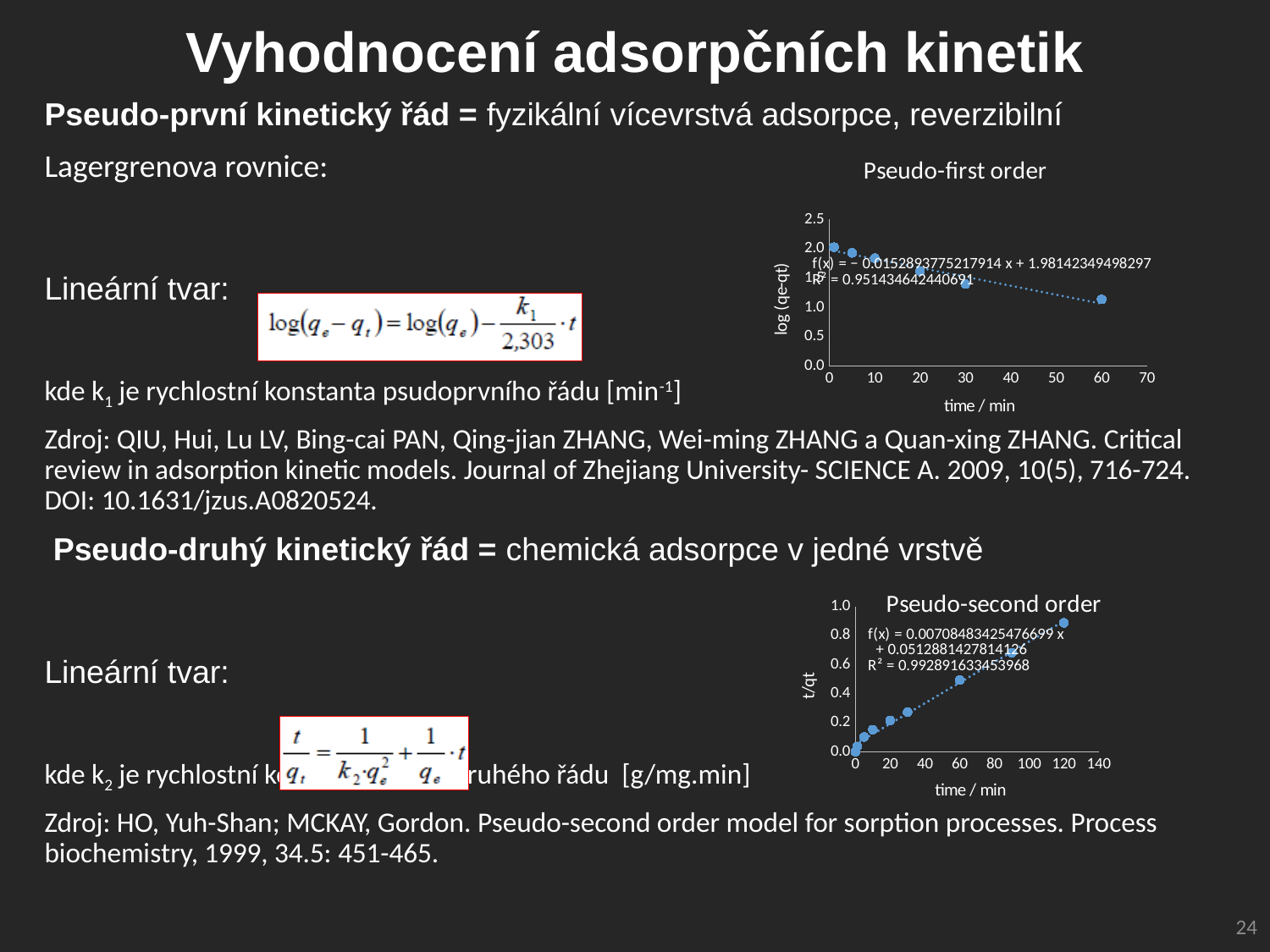
In the 'Pseudo-second order' chart, is the value at time 120 min greater or less than 0.8? greater In the 'Pseudo-first order' chart, do the values rise or fall as time increases? fall In the 'Pseudo-first order' chart, which has the larger value: the point at time 10 min or the point at time 60 min? time 10 min In the 'Pseudo-first order' chart, is the value at time 60 min greater or less than 1.5? less What kind of chart is the 'Pseudo-second order' chart? scatter chart In the 'Pseudo-second order' chart, is the value at time 20 min greater or less than 0.4? less What R² value is printed on the 'Pseudo-second order' chart? 0.992891633453968 What kind of chart is the 'Pseudo-first order' chart? scatter chart In the 'Pseudo-second order' chart, do the values rise or fall as time increases? rise What is the y-axis label of the 'Pseudo-second order' chart? t/qt